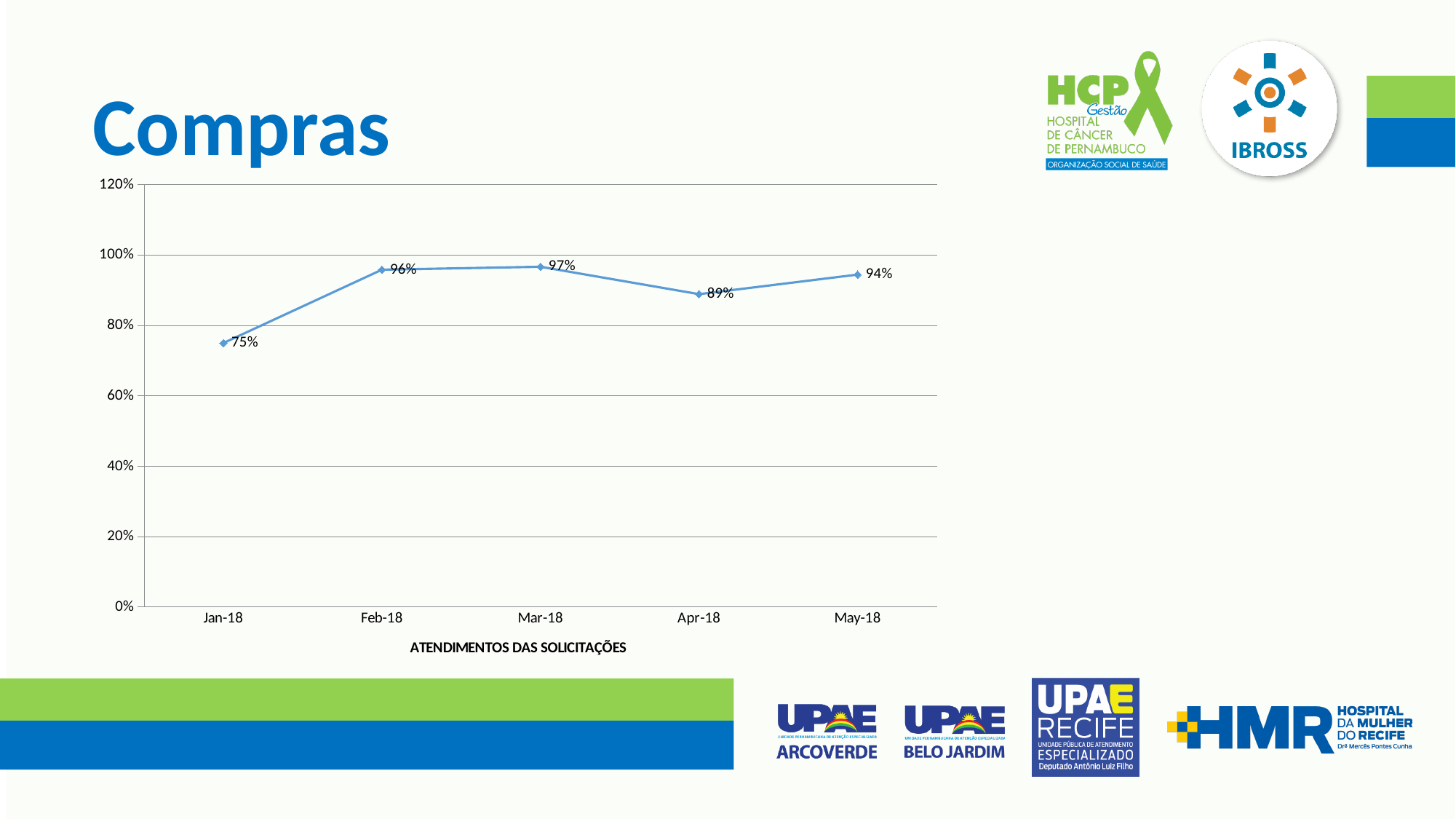
What is the difference between the values for Feb-18 and Jan-18? 21% Which is larger, the value for Feb-18 or the value for May-18? Feb-18 How many months are plotted on the chart? 5 Is the value for Jan-18 greater or less than 80%? less What is the value for Apr-18? 89% What is the label shown below the x axis of the chart? ATENDIMENTOS DAS SOLICITAÇÕES What is the value for Jan-18? 75% What is the difference between the values for Mar-18 and Apr-18? 8% Which month has the lowest value? Jan-18 What kind of chart is shown on the slide? line chart Which month has the highest value? Mar-18 What is the value for May-18? 94%